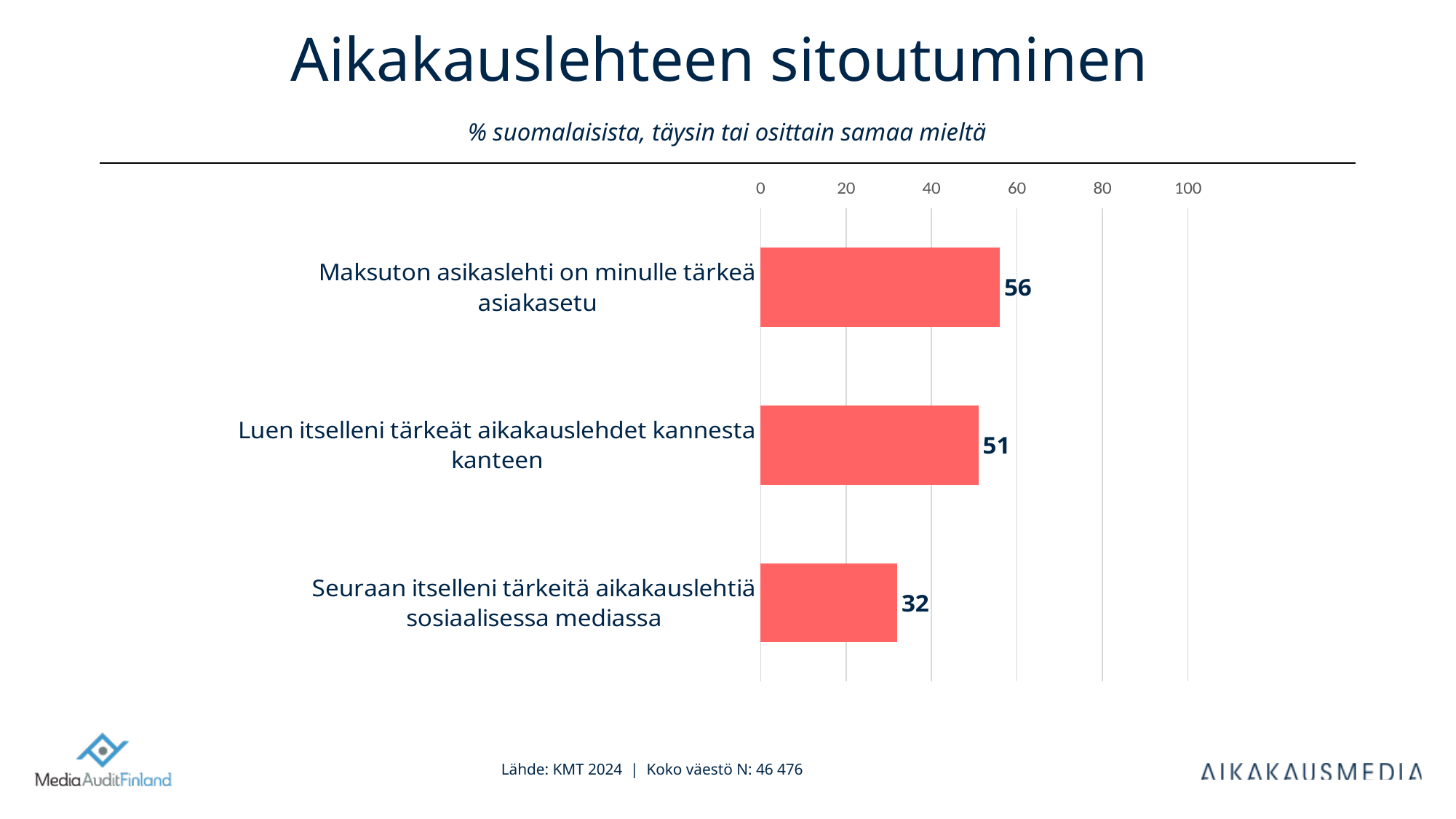
Which is larger: the value for "Luen itselleni tärkeät aikakauslehdet kannesta kanteen" or for "Seuraan itselleni tärkeitä aikakauslehtiä sosiaalisessa mediassa"? Luen itselleni tärkeät aikakauslehdet kannesta kanteen What is the value for "Luen itselleni tärkeät aikakauslehdet kannesta kanteen"? 51 What kind of chart is shown on the slide? bar chart Which category has the lowest value? Seuraan itselleni tärkeitä aikakauslehtiä sosiaalisessa mediassa What is the value for "Seuraan itselleni tärkeitä aikakauslehtiä sosiaalisessa mediassa"? 32 What is the difference between the values for "Maksuton asikaslehti on minulle tärkeä asiakasetu" and "Seuraan itselleni tärkeitä aikakauslehtiä sosiaalisessa mediassa"? 24 How many categories are shown in the chart? 3 Is the value for "Seuraan itselleni tärkeitä aikakauslehtiä sosiaalisessa mediassa" greater or less than 40? less Which category has the highest value? Maksuton asikaslehti on minulle tärkeä asiakasetu What is the difference between the values for "Maksuton asikaslehti on minulle tärkeä asiakasetu" and "Luen itselleni tärkeät aikakauslehdet kannesta kanteen"? 5 What is the title of the slide? Aikakauslehteen sitoutuminen What is the value for "Maksuton asikaslehti on minulle tärkeä asiakasetu"? 56